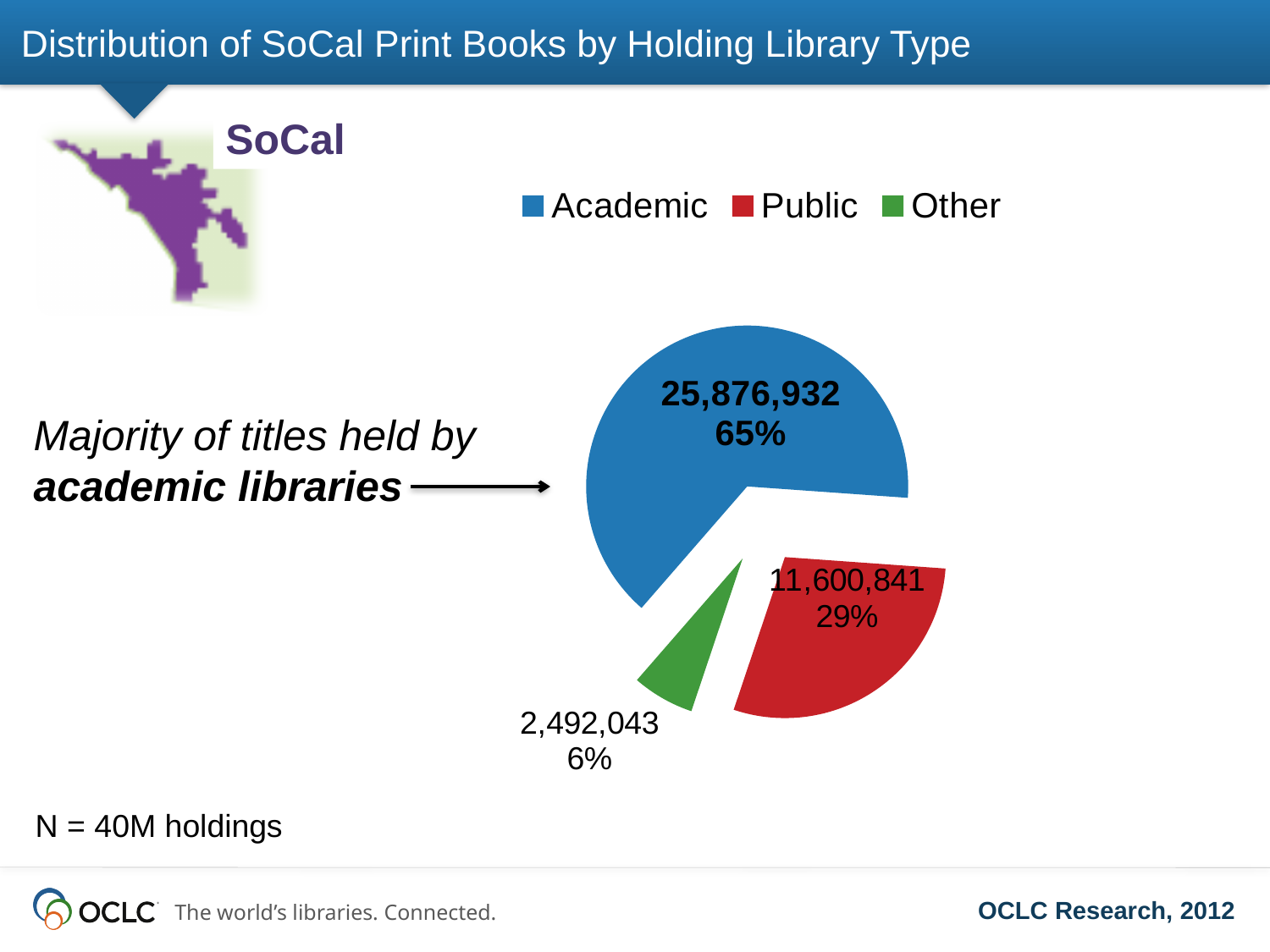
What share of the pie is the Public slice? 29% How many holdings does the Academic slice represent? 25,876,932 Which library type holds the largest share of SoCal print books? Academic What is the difference in holdings between the Academic and Public slices? 14,276,091 What share of the pie is the Other slice? 6% How many holdings does the Other slice represent? 2,492,043 How many holdings does the Public slice represent? 11,600,841 How many slices does the pie chart have? 3 Which is larger, the Public slice or the Other slice? Public Which library type holds the smallest share of SoCal print books? Other What kind of chart is shown on the slide? pie chart What colour is the Academic slice? blue